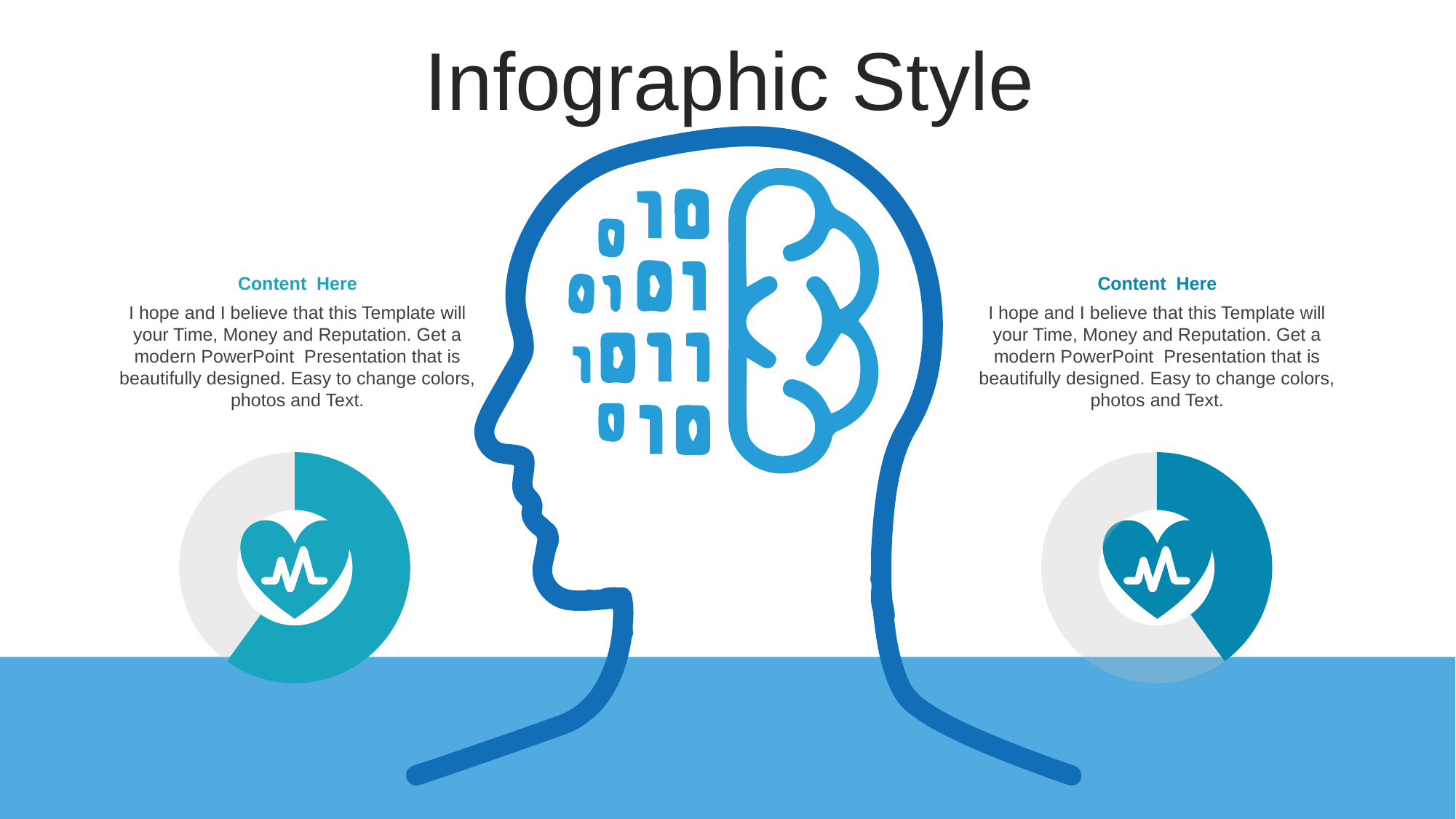
How many slices does the chart on the right side of the slide have? 2 What kind of chart is the chart on the right side of the slide? doughnut chart What icon is shown in the centre of the chart on the left side of the slide? a heart with a heartbeat line How many pie charts are shown on the slide? 2 In the chart on the right side of the slide, which slice is larger, the blue slice or the grey slice? the blue slice How many slices does the chart on the left side of the slide have? 2 In the chart on the left side of the slide, does the teal slice take up more or less than half of the pie? more In the chart on the left side of the slide, which slice is larger, the teal slice or the grey slice? the teal slice What kind of chart is the chart on the left side of the slide? doughnut chart In the chart on the right side of the slide, does the grey slice take up more or less than half of the pie? less What colour is the larger slice of the chart on the right side of the slide? blue